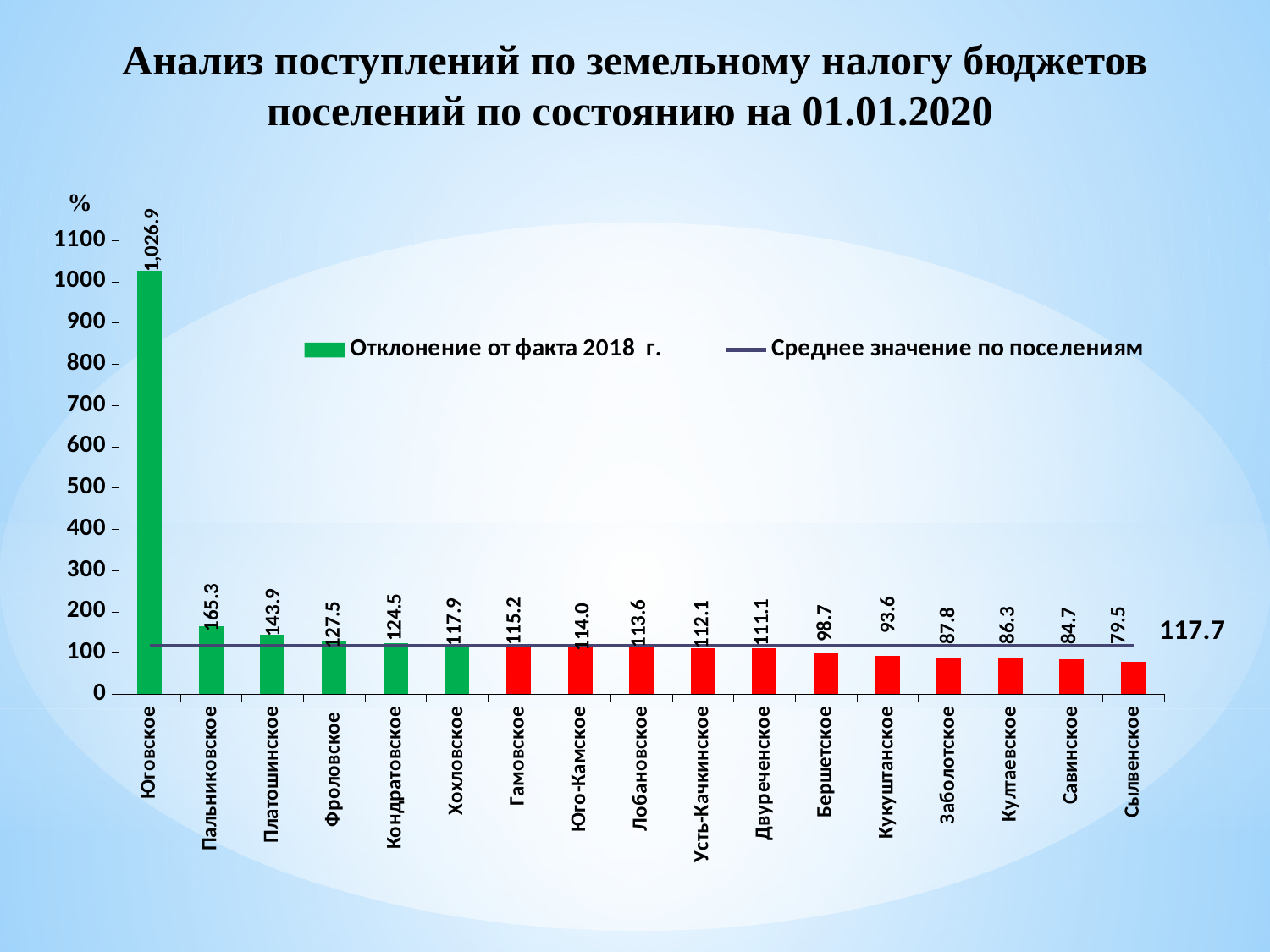
What is the value of the average line (Среднее значение по поселениям)? 117.7 What is the value for Юговское? 1,026.9 What is the value for Пальниковское? 165.3 How many entries does the legend list? 2 What is the difference between the values for Пальниковское and Платошинское? 21.4 Which is larger, the value for Фроловское or the value for Бершетское? Фроловское Which settlement has the highest value? Юговское How many settlements are shown on the x axis? 17 What kind of chart is shown on the slide? combination bar and line chart What is the value for Сылвенское? 79.5 Which settlement has the lowest value? Сылвенское Is the value for Юговское greater or less than 1000? greater